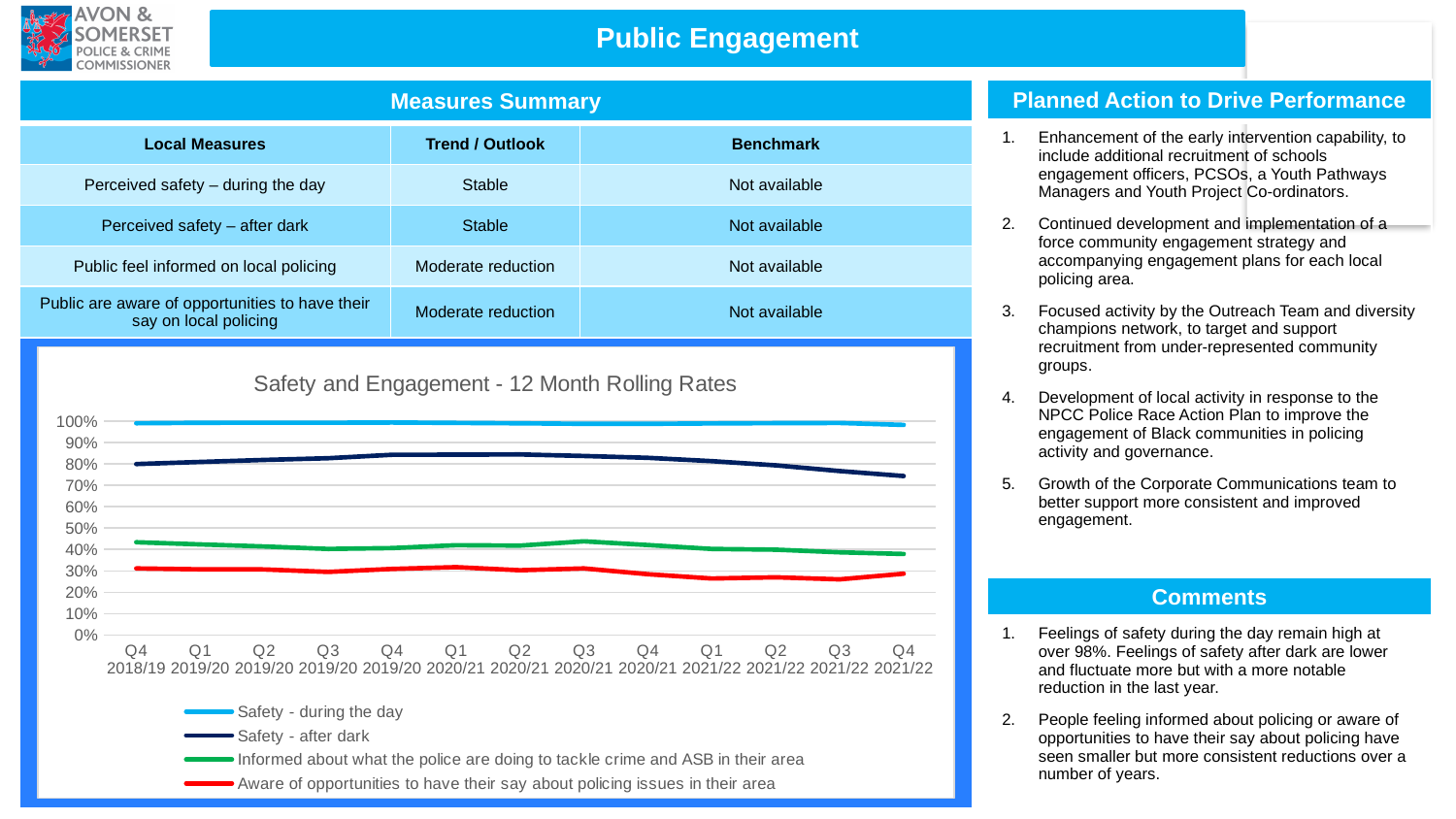
How many quarters are plotted along the x axis of the chart? 13 Is the value for 'Safety - after dark' in Q4 2021/22 greater or less than 80%? less Does the 'Safety - after dark' line rise or fall between Q4 2020/21 and Q4 2021/22? Fall Is the value for 'Safety - during the day' in Q4 2021/22 greater or less than 90%? greater Is the value for 'Aware of opportunities to have their say about policing issues in their area' in Q1 2021/22 greater or less than 30%? less Which series has the highest values throughout the chart? Safety - during the day How many series does the legend of the 'Safety and Engagement - 12 Month Rolling Rates' chart list? 4 Which is larger in Q4 2021/22: 'Safety - after dark' or 'Informed about what the police are doing to tackle crime and ASB in their area'? Safety - after dark What type of chart is shown on the slide? Line chart Which series has the lowest values throughout the chart? Aware of opportunities to have their say about policing issues in their area What is the title of the chart? Safety and Engagement - 12 Month Rolling Rates